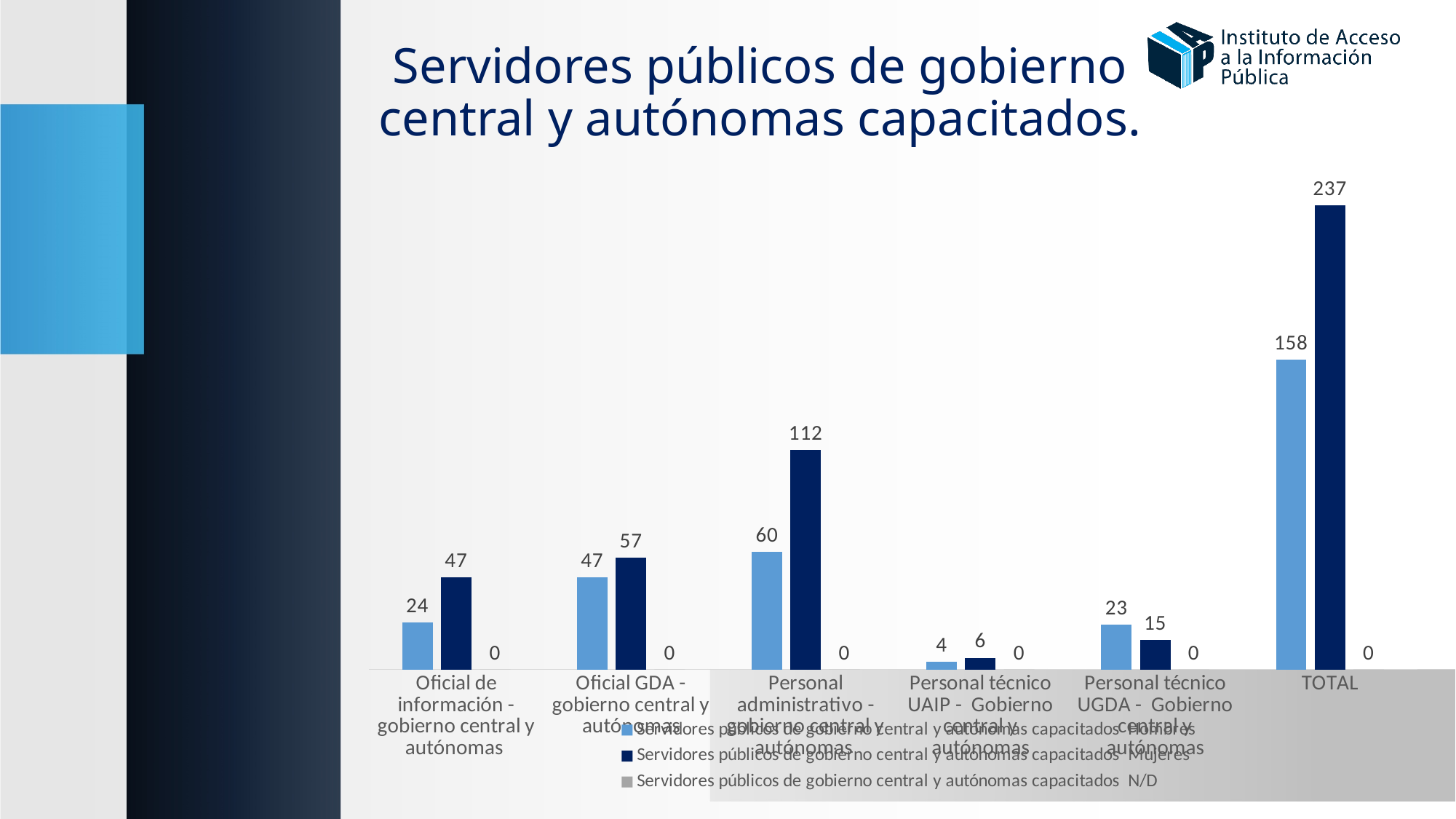
What is the Mujeres value for the TOTAL category? 237 Which category has the lowest Hombres value? Personal técnico UAIP - Gobierno central y autónomas For Personal técnico UGDA - Gobierno central y autónomas, which is larger, the Hombres value or the Mujeres value? Hombres What is the difference between the Mujeres and Hombres values in the TOTAL category? 79 What is the Mujeres value for Personal administrativo - gobierno central y autónomas? 112 What is the Hombres value for Personal técnico UGDA - Gobierno central y autónomas? 23 What kind of chart is shown on the slide? Bar chart What is the N/D value for Oficial GDA - gobierno central y autónomas? 0 Excluding TOTAL, which category has the highest Mujeres value? Personal administrativo - gobierno central y autónomas How many categories are shown on the x axis of the chart? 6 What is the Hombres value for Oficial de información - gobierno central y autónomas? 24 How many series does the legend list? 3